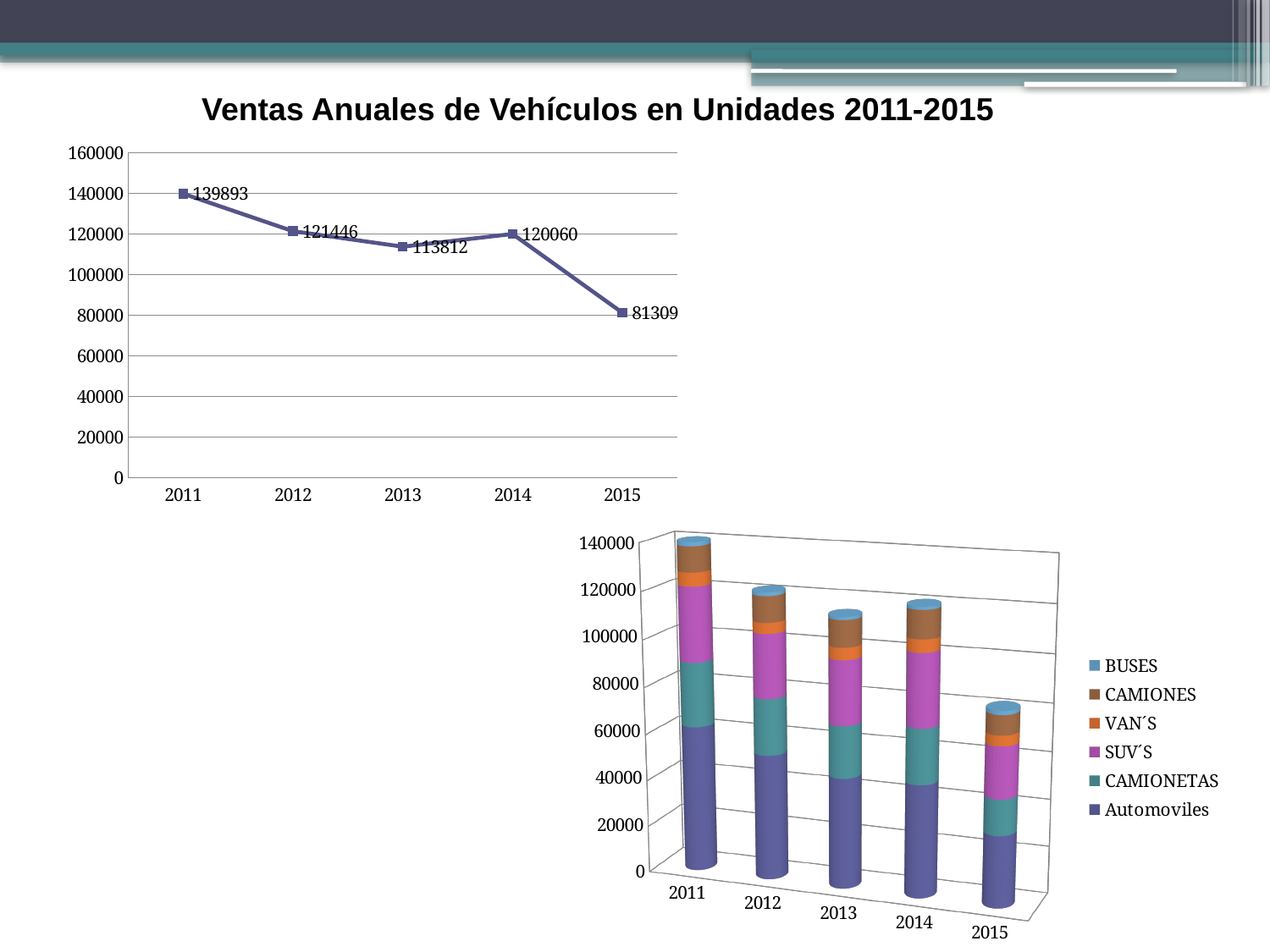
On the line chart at the top, what was the value for 2011? 139893 On the line chart at the top, which is larger, the value for 2013 or the value for 2014? 2014 On the line chart at the top, which year has the highest value? 2011 On the line chart at the top, which year has the lowest value? 2015 On the stacked bar chart at the bottom right, how many series does the legend list? 6 On the line chart at the top, how many data points are plotted? 5 What is the title of the chart at the top of the slide? Ventas Anuales de Vehículos en Unidades 2011-2015 On the line chart at the top, what was the value for 2015? 81309 On the line chart at the top, what is the difference between the 2011 value and the 2012 value? 18447 On the stacked bar chart at the bottom right, is the Automoviles value for 2011 greater or less than 40000? greater On the stacked bar chart at the bottom right, which year has the lowest total bar? 2015 What kind of chart is shown at the bottom right of the slide? Stacked bar chart